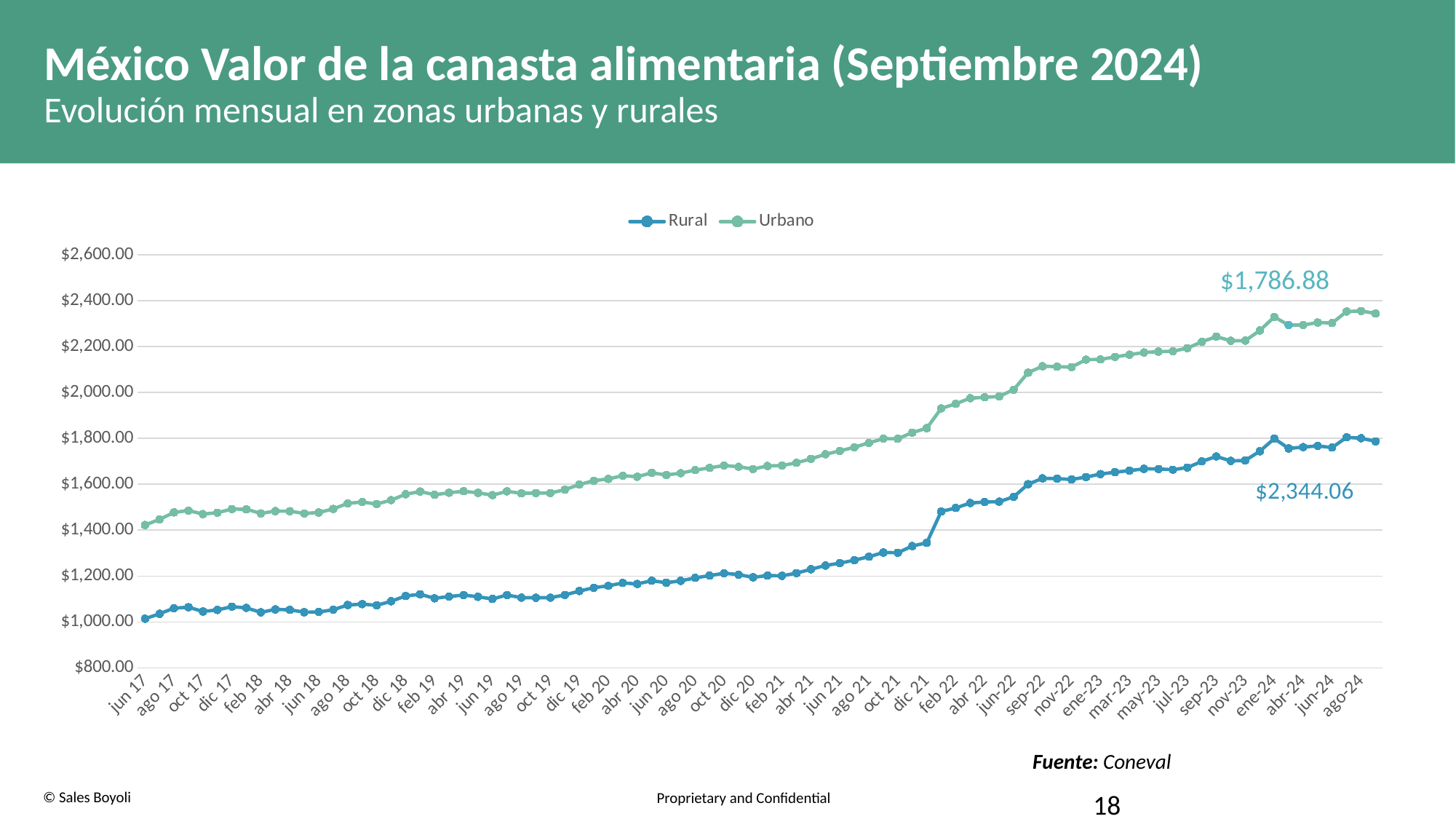
Is the Urbano value for ago-24 greater or less than $2,200.00? greater Which series has the higher value in ago-24, Rural or Urbano? Urbano What kind of chart is shown on the slide? line chart Which of the two data labels printed on the chart is the larger value? $2,344.06 What are the two series named in the legend? Rural and Urbano Which series is higher across the whole period shown? Urbano How many series does the legend list? 2 Is the Rural value for jun 17 greater or less than $1,200.00? less Do the Rural values rise or fall from jun 17 to ago-24? rise Is the Rural value for ago-24 greater or less than $1,600.00? greater What is the title of the slide containing the chart? México Valor de la canasta alimentaria (Septiembre 2024)